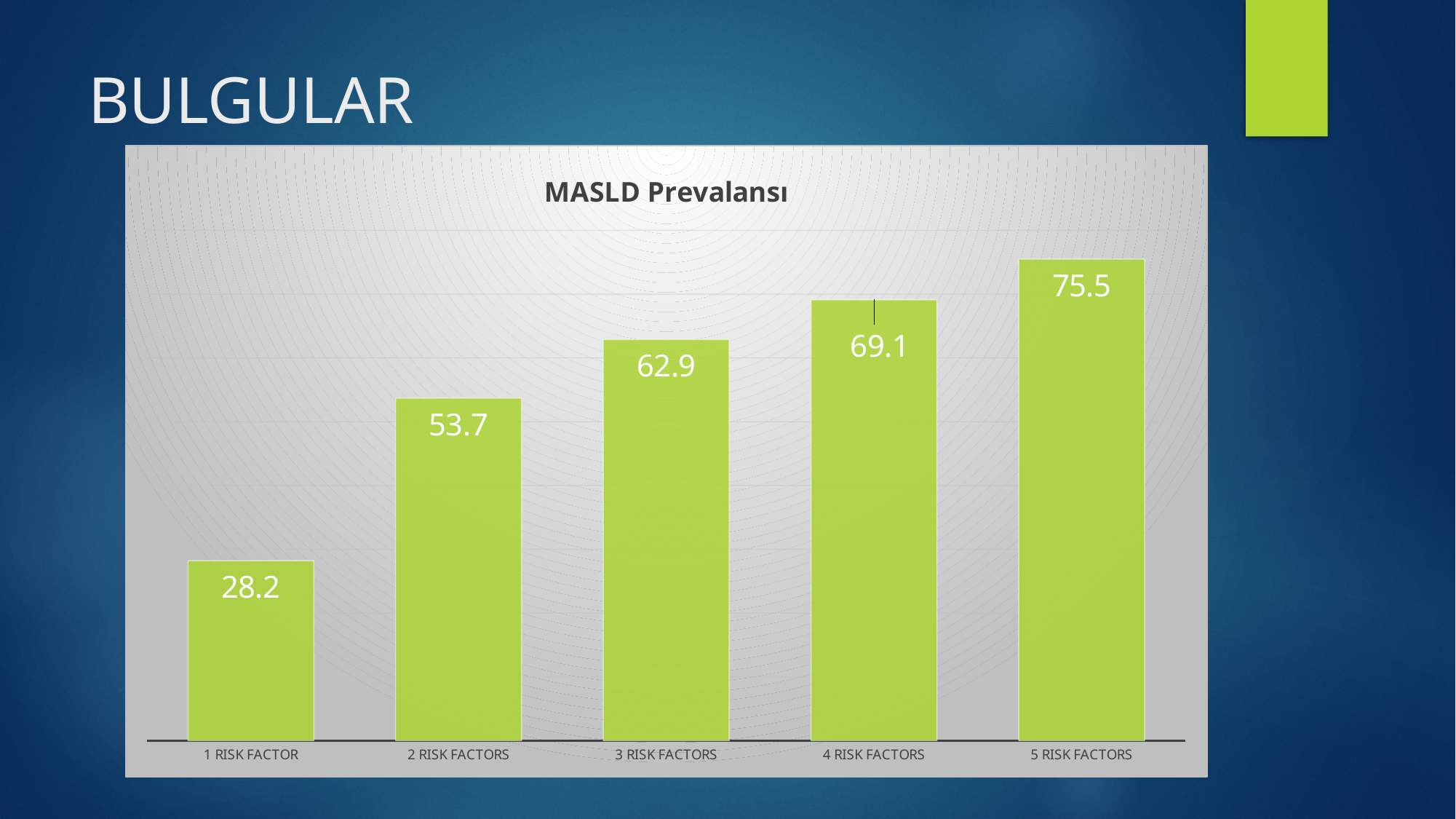
What is the difference between the values for 5 RISK FACTORS and 4 RISK FACTORS? 6.4 How many categories are shown on the x axis? 5 What is the title of the chart? MASLD Prevalansı What is the value for 5 RISK FACTORS? 75.5 Do the values rise or fall as the number of risk factors increases along the x axis? rise Which category has the lowest value? 1 RISK FACTOR What is the difference between the values for 2 RISK FACTORS and 1 RISK FACTOR? 25.5 Which category has the highest value? 5 RISK FACTORS Which is larger, the value for 2 RISK FACTORS or the value for 4 RISK FACTORS? 4 RISK FACTORS What is the value for 3 RISK FACTORS? 62.9 What kind of chart is this? bar chart What is the value for 1 RISK FACTOR? 28.2